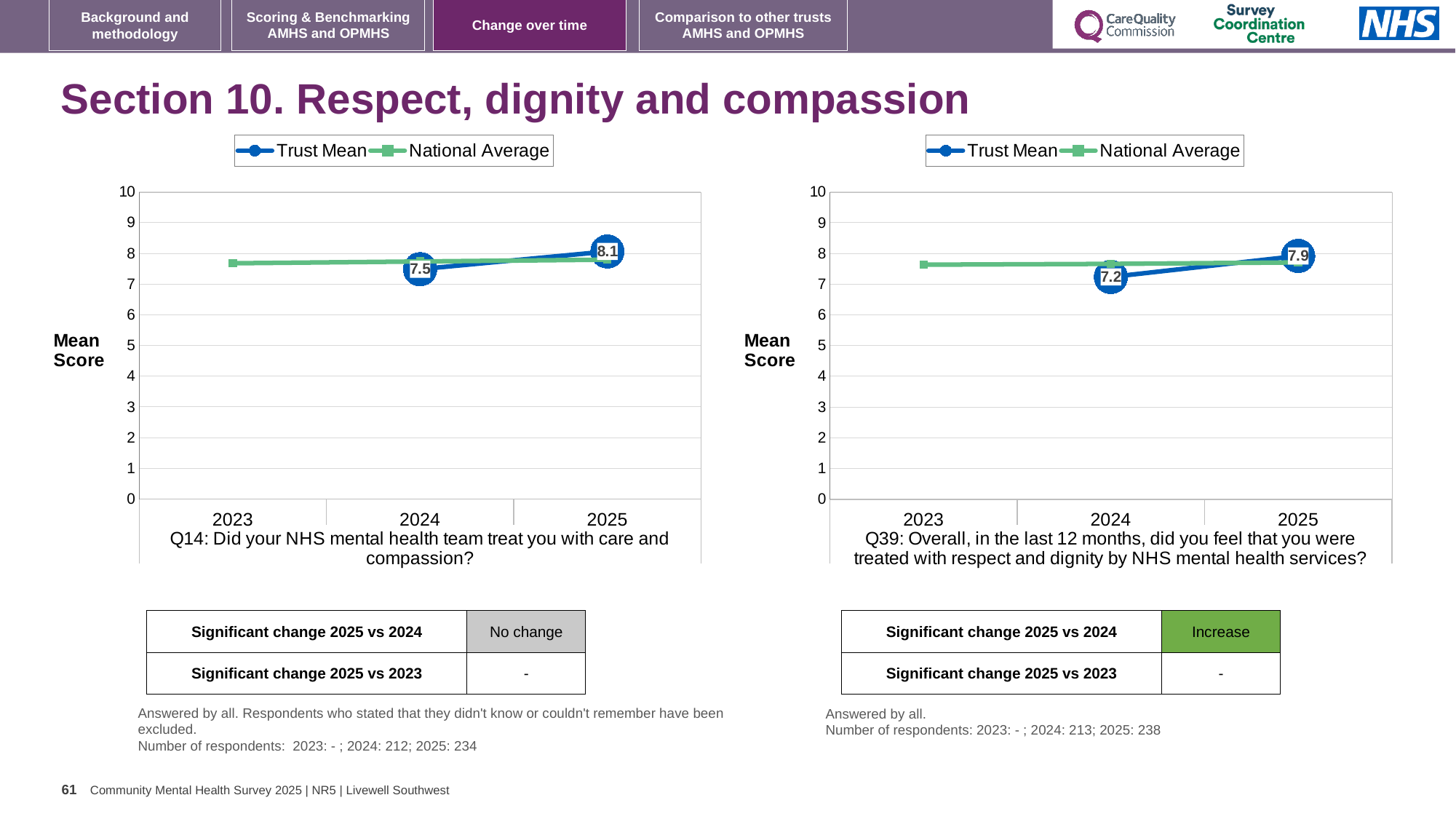
On the Q39 chart (right), what is the difference between the Trust Mean in 2025 and in 2024? 0.7 On the Q39 chart (right), what is the Trust Mean for 2025? 7.9 On the Q39 chart (right), does the Trust Mean rise or fall from 2024 to 2025? rise How many years are shown on the x axis of the Q14 chart (left)? 3 On the Q14 chart (left), by how much did the Trust Mean change from 2024 to 2025? 0.6 On the Q39 chart (right), is the National Average for 2023 greater or less than 5? greater On the Q14 chart (left), what is the Trust Mean for 2024? 7.5 On the Q39 chart (right), what is the Trust Mean for 2024? 7.2 How many series does the legend of the Q14 chart (left) list? 2 On the Q14 chart (left), what is the Trust Mean for 2025? 8.1 What kind of chart is the Q39 chart (right)? line chart On the Q14 chart (left), which year has the higher Trust Mean, 2024 or 2025? 2025